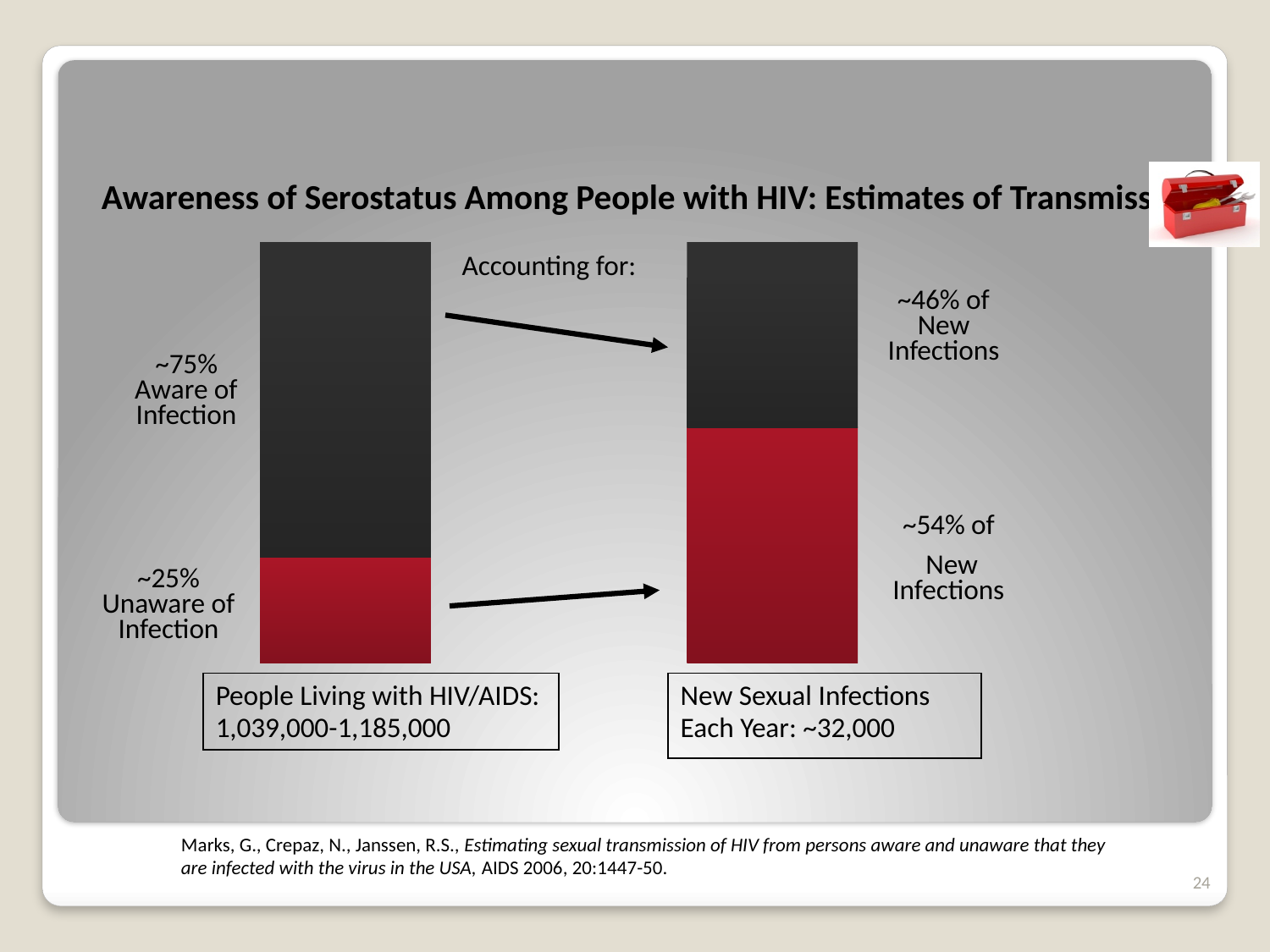
What share of people living with HIV/AIDS is shown as unaware of infection in the left bar? ~25% Is the share of new infections from people unaware of their infection greater or less than 50%? greater In the left bar, which segment is larger: aware of infection or unaware of infection? Aware of Infection In the right bar, what share of new infections is attributed to people unaware of their infection (red segment)? ~54% of New Infections In the right bar, what share of new infections is attributed to people aware of their infection (dark segment)? ~46% of New Infections In the right bar, which segment is larger: the dark (aware) segment or the red (unaware) segment? The red (unaware) segment What is the label under the right bar? New Sexual Infections Each Year: ~32,000 What kind of chart is shown on the slide? Stacked bar chart What share of people living with HIV/AIDS is shown as aware of infection in the left bar? ~75% How many stacked bars are shown on the slide? 2 Is the share of people living with HIV/AIDS who are unaware of infection greater or less than 50%? less What is the label under the left bar? People Living with HIV/AIDS: 1,039,000-1,185,000